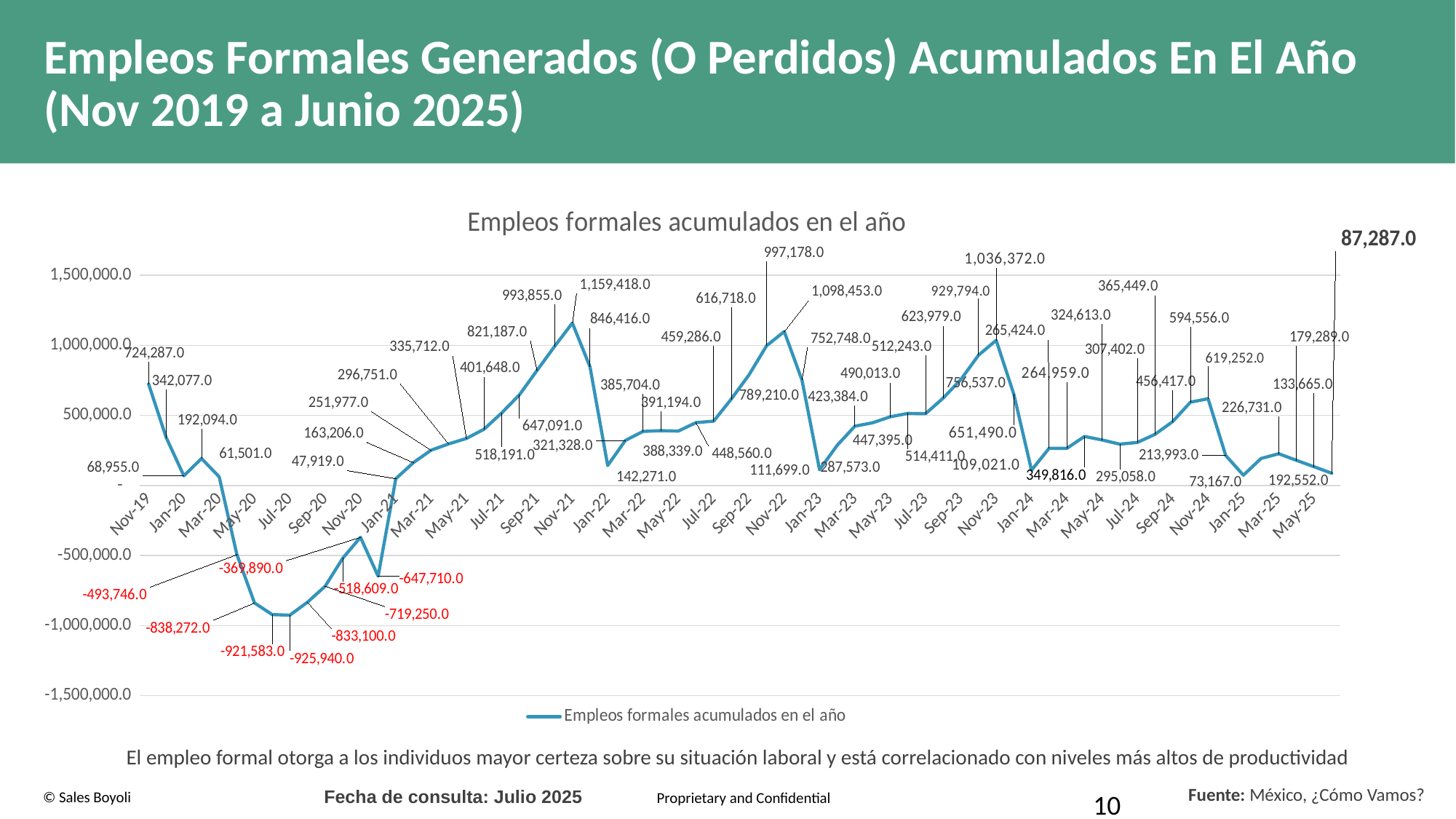
What is the difference between the highest value (1,159,418.0) and the lowest value (-925,940.0) on the chart? 2,085,358.0 Is the value for Jul-20 greater or less than -500,000.0? less Which is larger, the peak value in Nov-21 (1,159,418.0) or the peak value in Nov-22 (1,098,453.0)? Nov-21 (1,159,418.0) Is the value for Nov-21 greater or less than 1,000,000.0? greater Do the values rise or fall from Jan-21 to Nov-21? rise What is the lowest value plotted on the chart? -925,940.0 What is the value for Nov-19, the first point on the chart? 724,287.0 What is the title of the chart? Empleos formales acumulados en el año What is the value for the last point on the chart (Jun-25)? 87,287.0 What kind of chart is shown on the slide? line chart How many series does the legend list? 1 What is the highest value plotted on the chart? 1,159,418.0